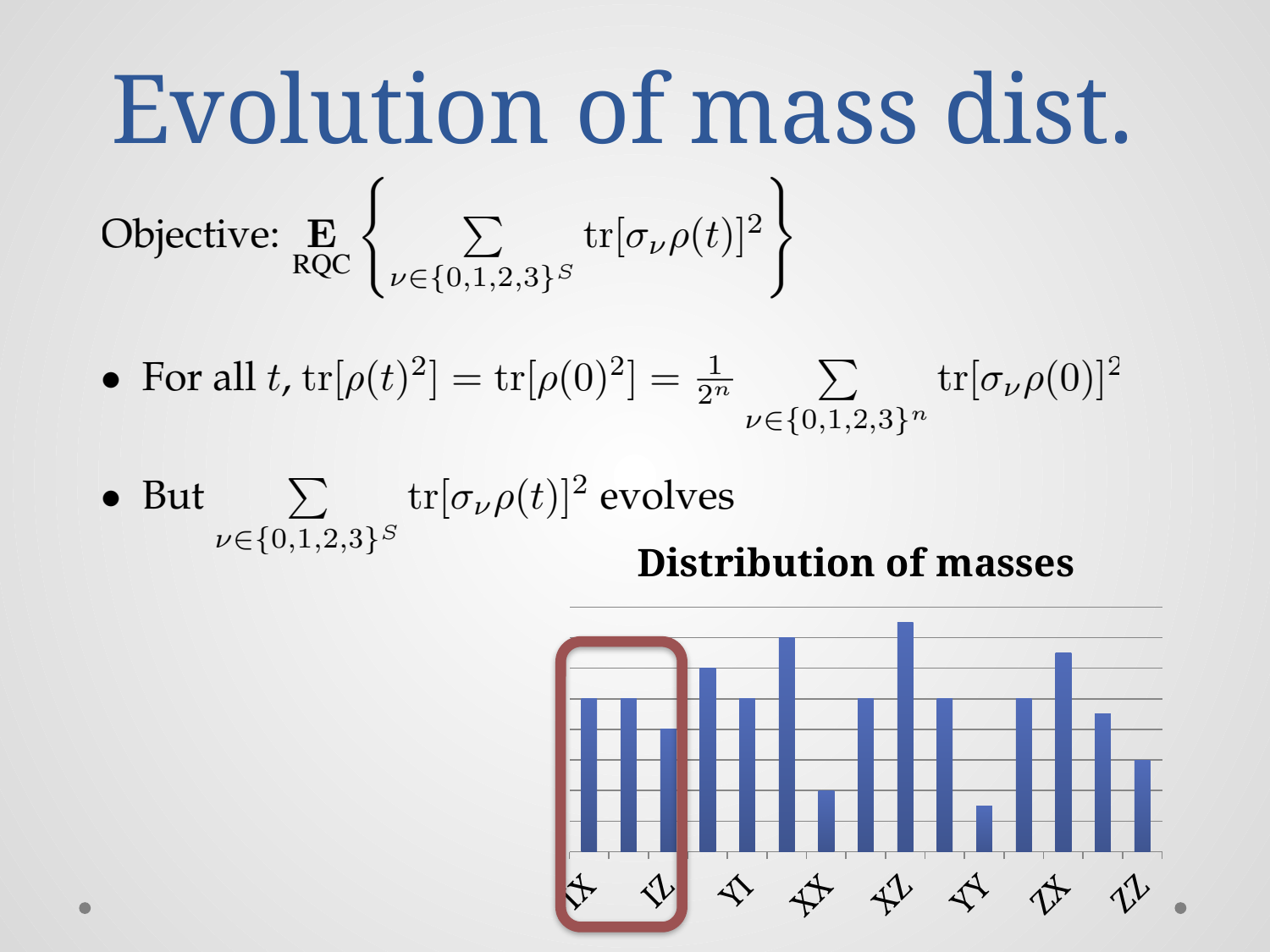
What kind of chart is shown on the slide? bar chart In the Distribution of masses chart, which bar is taller, XX or ZZ? ZZ How many category labels are readable on the x axis of the chart? 8 Which x-axis labels are enclosed by the red rounded rectangle on the chart? IX and IZ In the Distribution of masses chart, which bar is taller, YI or ZX? ZX In the Distribution of masses chart, which bar is taller, IX or IZ? IX How many bars are plotted in the Distribution of masses chart? 15 Which labeled category has the shortest bar in the Distribution of masses chart? YY Which labeled category has the tallest bar in the Distribution of masses chart? XZ What is the title of the chart on the slide? Distribution of masses